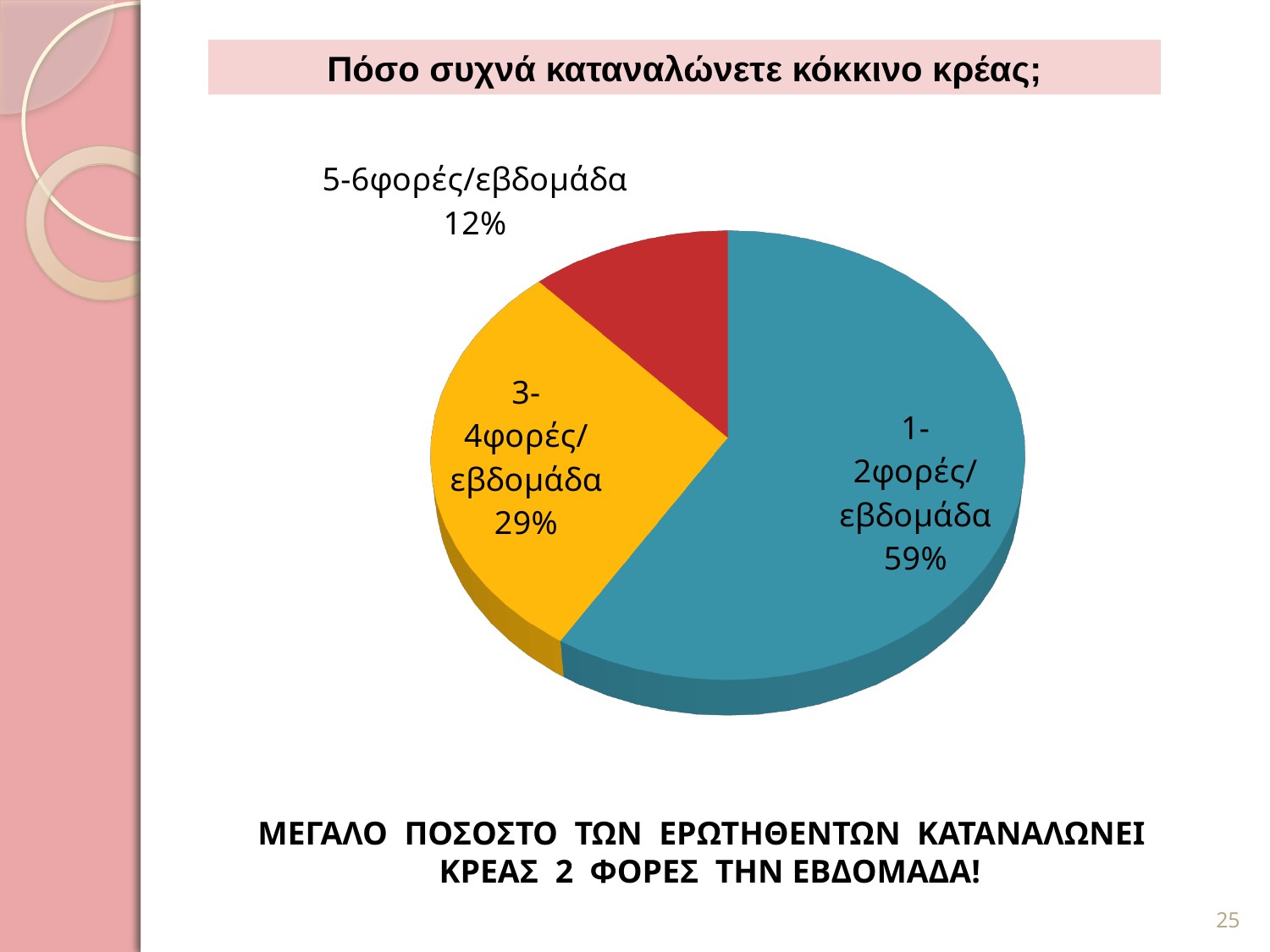
Which is larger: the share for 3-4φορές/εβδομάδα or the share for 5-6φορές/εβδομάδα? 3-4φορές/εβδομάδα What share of respondents eat red meat 3-4 times per week (3-4φορές/εβδομάδα)? 29% What share of respondents eat red meat 5-6 times per week (5-6φορές/εβδομάδα)? 12% What colour is the slice for 1-2φορές/εβδομάδα? Blue Which category has the smallest share of the pie? 5-6φορές/εβδομάδα What is the difference in percentage points between the 1-2φορές/εβδομάδα slice and the 3-4φορές/εβδομάδα slice? 30 What is the difference in percentage points between the 3-4φορές/εβδομάδα slice and the 5-6φορές/εβδομάδα slice? 17 What is the title of the chart on the slide? Πόσο συχνά καταναλώνετε κόκκινο κρέας; Which category has the largest share of the pie? 1-2φορές/εβδομάδα What kind of chart is shown on the slide? Pie chart How many categories (slices) does the pie chart have? 3 What share of respondents eat red meat 1-2 times per week (1-2φορές/εβδομάδα)? 59%